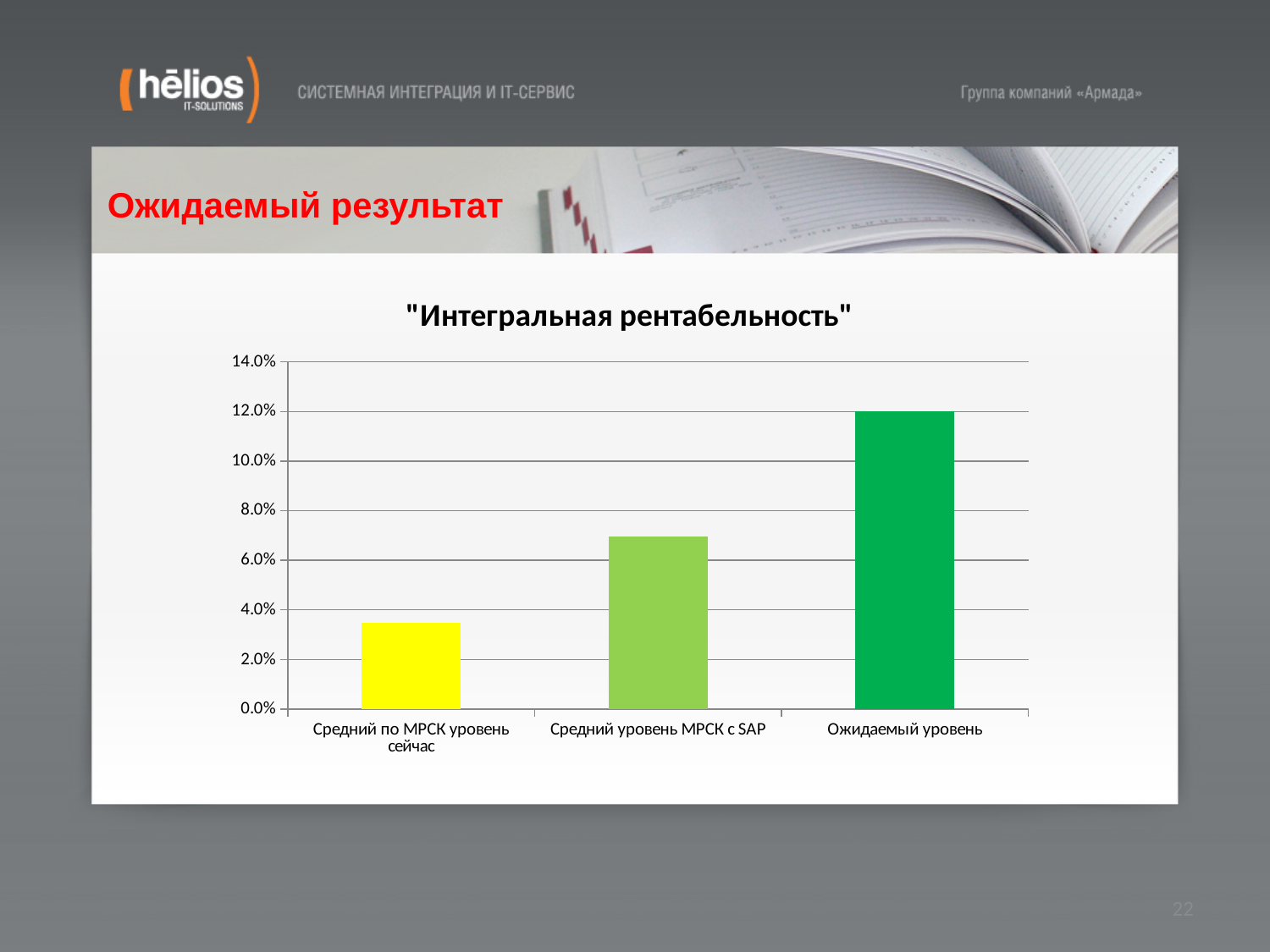
How many bars (categories) does the chart show? 3 What is the value for Ожидаемый уровень? 12.0% What is the title of the chart? "Интегральная рентабельность" What colour is the bar for Ожидаемый уровень? green Is the value for Средний уровень МРСК с SAP greater or less than 8.0%? less Which is larger: the value for Средний уровень МРСК с SAP or the value for Средний по МРСК уровень сейчас? Средний уровень МРСК с SAP Is the value for Средний уровень МРСК с SAP greater or less than 6.0%? greater Is the value for Средний по МРСК уровень сейчас greater or less than 4.0%? less Do the values rise or fall from left to right along the x axis? rise What kind of chart is shown on the slide? bar chart Which category has the lowest value? Средний по МРСК уровень сейчас Which category has the highest value? Ожидаемый уровень